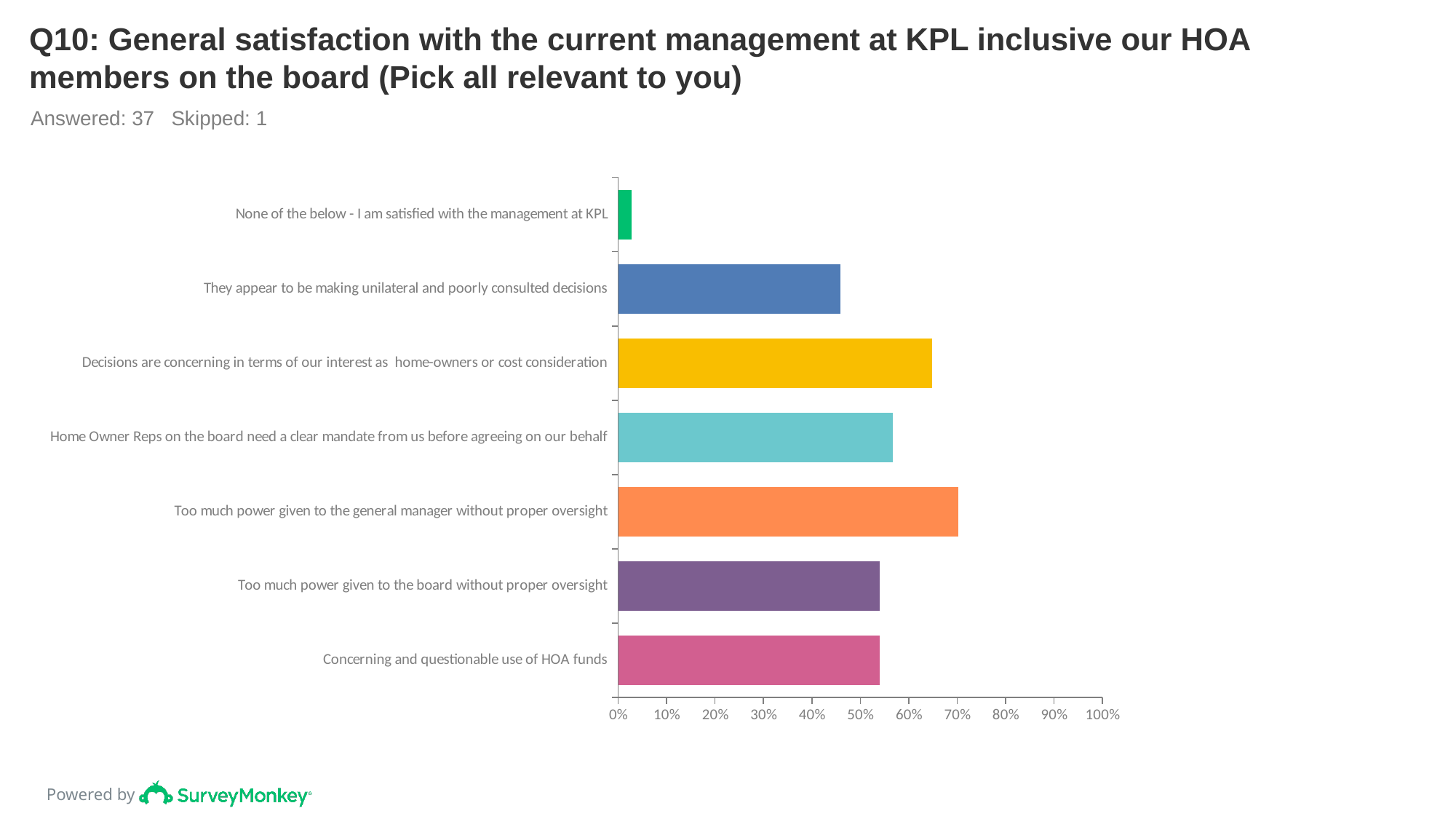
Which is larger: the value for "Decisions are concerning in terms of our interest as home-owners or cost consideration" or the value for "Home Owner Reps on the board need a clear mandate from us before agreeing on our behalf"? Decisions are concerning in terms of our interest as home-owners or cost consideration Is the value for "Concerning and questionable use of HOA funds" greater or less than 50%? greater Is the value for "None of the below - I am satisfied with the management at KPL" greater or less than 10%? less According to the slide, how many respondents answered this question? 37 How many categories (response options) are plotted in the chart? 7 Is the value for "Too much power given to the general manager without proper oversight" greater or less than 60%? greater Which is larger: the value for "They appear to be making unilateral and poorly consulted decisions" or the value for "Too much power given to the board without proper oversight"? Too much power given to the board without proper oversight Which response option has the highest value? Too much power given to the general manager without proper oversight What kind of chart is shown on the slide? bar chart Which response option has the lowest value? None of the below - I am satisfied with the management at KPL